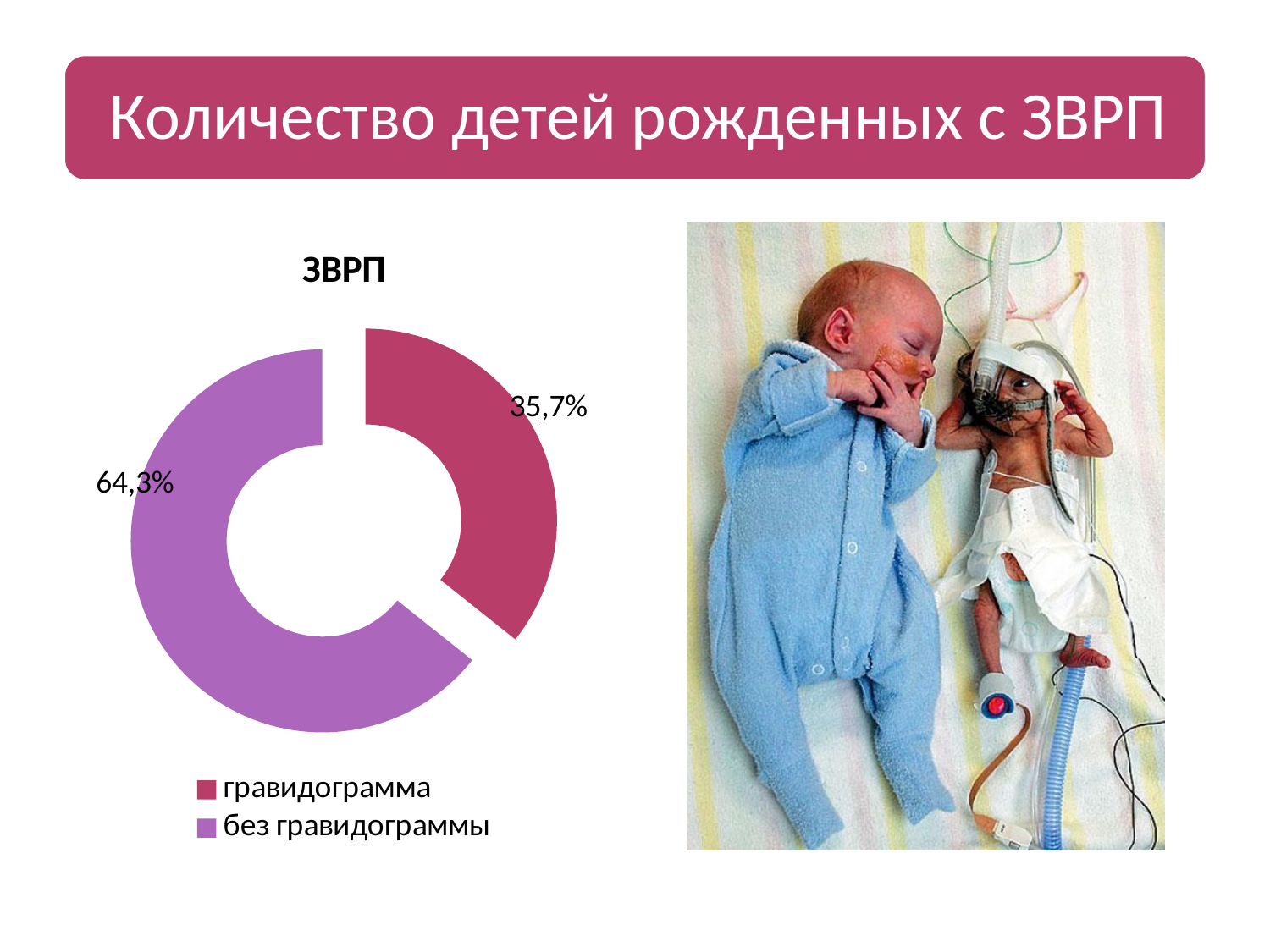
Which category has the largest share of the chart? без гравидограммы What percentage is shown for the "гравидограмма" slice? 35,7% How many slices does the chart have? 2 Which category has the smallest share of the chart? гравидограмма What colour is the "без гравидограммы" slice? Purple What kind of chart is shown on the slide? Doughnut (pie) chart What is the difference in percentage points between the "без гравидограммы" and "гравидограмма" slices? 28,6 What is the title of the chart? ЗВРП How many entries does the legend list? 2 What percentage is shown for the "без гравидограммы" slice? 64,3% Which slice is larger: "гравидограмма" or "без гравидограммы"? без гравидограммы